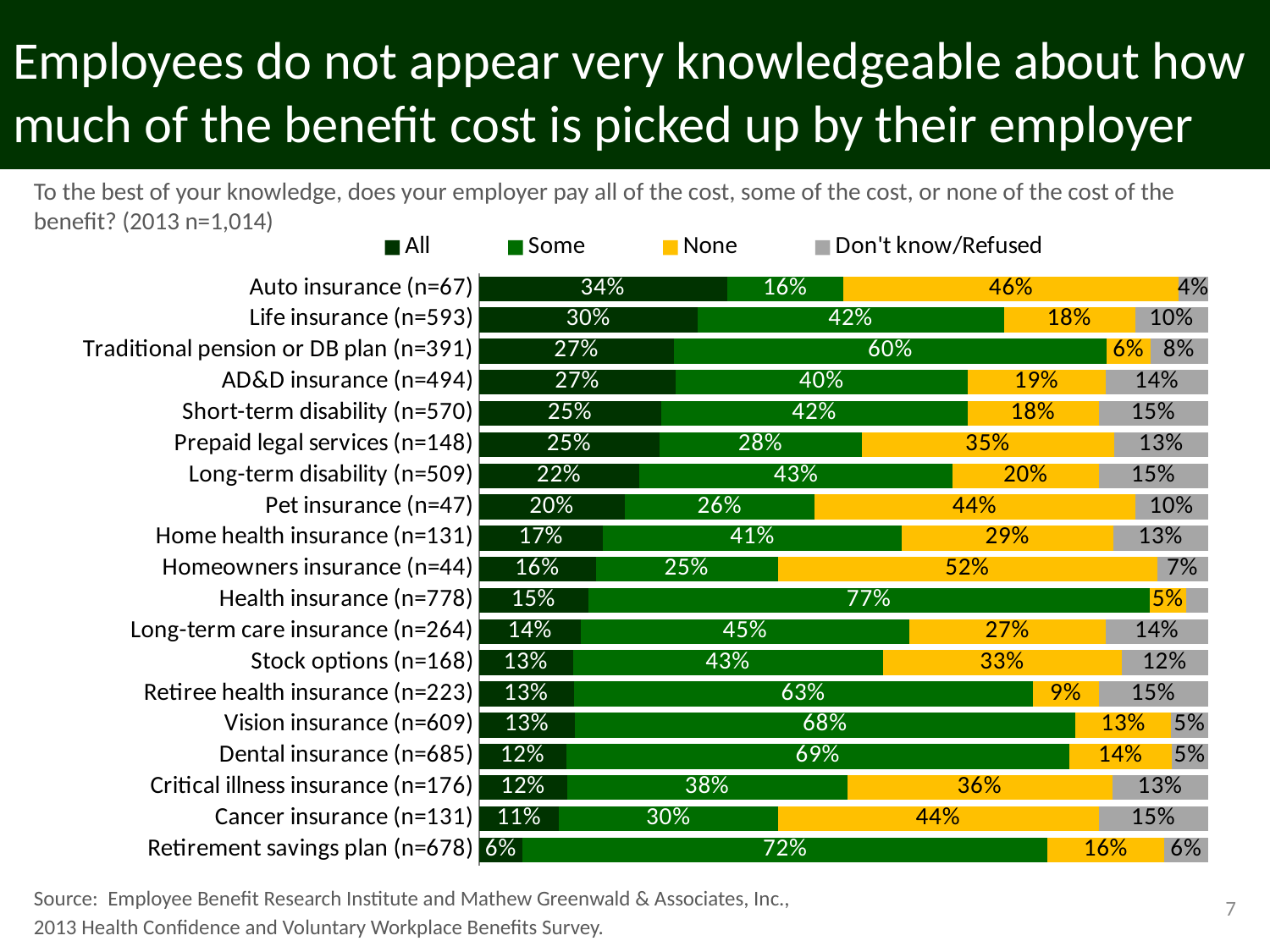
What percentage of respondents said their employer pays some of the cost of health insurance? 77% What is the Don't know/Refused percentage for long-term disability? 15% Which is larger: the 'None' percentage for pet insurance or the 'None' percentage for cancer insurance? They are equal (44%) What percentage of respondents said their employer pays all of the cost of life insurance? 30% What percentage of respondents said their employer pays none of the cost of homeowners insurance? 52% Which benefit has the highest percentage in the 'Some' series? Health insurance (n=778) Which benefit has the highest percentage of respondents saying their employer pays all of the cost? Auto insurance (n=67) Which benefit has the lowest percentage of respondents saying their employer pays all of the cost? Retirement savings plan (n=678) What is the difference between the 'Some' percentage for dental insurance and the 'Some' percentage for vision insurance? 1% How many benefit categories are shown in the chart? 19 How many series does the legend list? 4 What type of chart is shown on the slide? Stacked bar chart